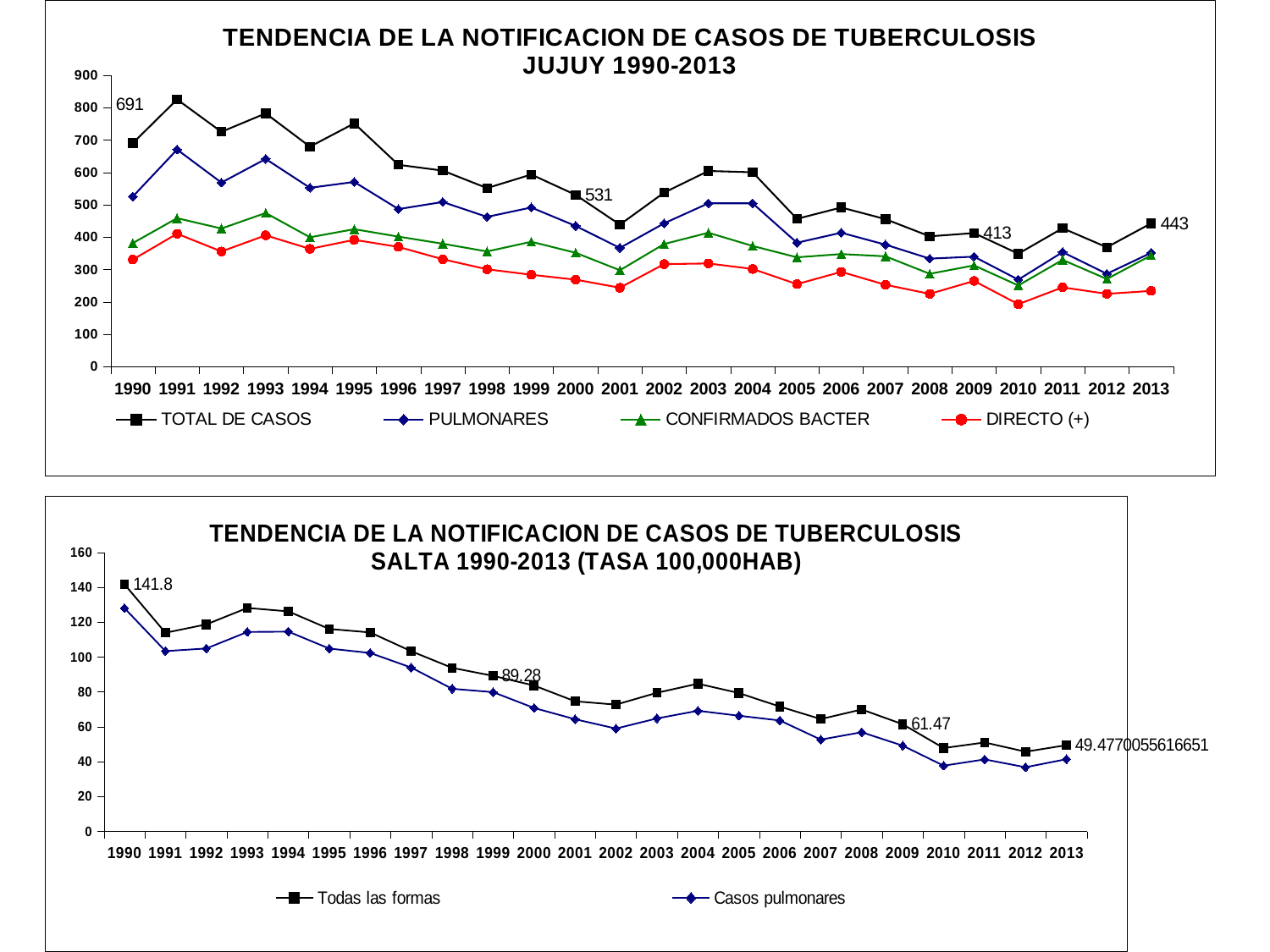
In the Salta chart (bottom), what kind of chart is shown? line chart In the Jujuy chart (top), what is the value of TOTAL DE CASOS in 2013? 443 In the Jujuy chart (top), how many series does the legend list? 4 In the Jujuy chart (top), which year has the highest TOTAL DE CASOS? 1991 In the Jujuy chart (top), what is the difference between the TOTAL DE CASOS values in 1990 and 2013? 248 In the Jujuy chart (top), what is the value of TOTAL DE CASOS in 1990? 691 In the Salta chart (bottom), what is the labelled value of Todas las formas in 2013? 49.4770055616651 In the Salta chart (bottom), what is the value of Todas las formas in 1990? 141.8 In the Salta chart (bottom), what is the labelled value of Todas las formas in 2009? 61.47 In the Jujuy chart (top), what is the labelled value of TOTAL DE CASOS in 2000? 531 In the Salta chart (bottom), do the Todas las formas values generally rise or fall from 1990 to 2013? fall